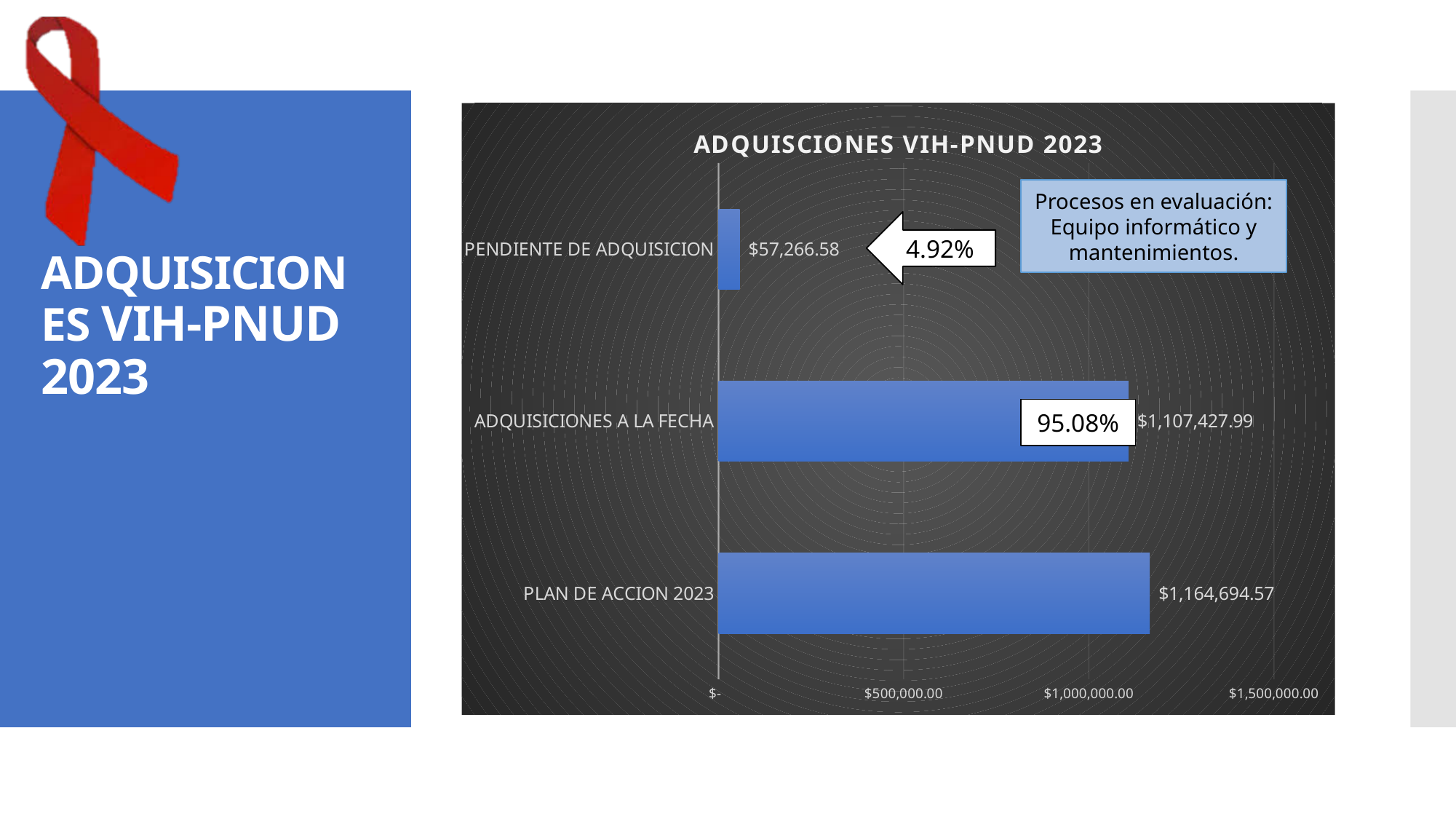
What kind of chart is shown on the slide? Bar chart How many categories are shown in the chart? 3 What is the difference between PLAN DE ACCION 2023 and ADQUISICIONES A LA FECHA? $57,266.58 What is the value for PENDIENTE DE ADQUISICION? $57,266.58 What is the value for PLAN DE ACCION 2023? $1,164,694.57 What is the value for ADQUISICIONES A LA FECHA? $1,107,427.99 Which category has the highest value? PLAN DE ACCION 2023 Is the value for PLAN DE ACCION 2023 greater or less than $1,000,000.00? greater Which is larger, ADQUISICIONES A LA FECHA or PENDIENTE DE ADQUISICION? ADQUISICIONES A LA FECHA What percentage is shown next to the ADQUISICIONES A LA FECHA bar? 95.08% Is the value for PENDIENTE DE ADQUISICION greater or less than $500,000.00? less Which category has the lowest value? PENDIENTE DE ADQUISICION